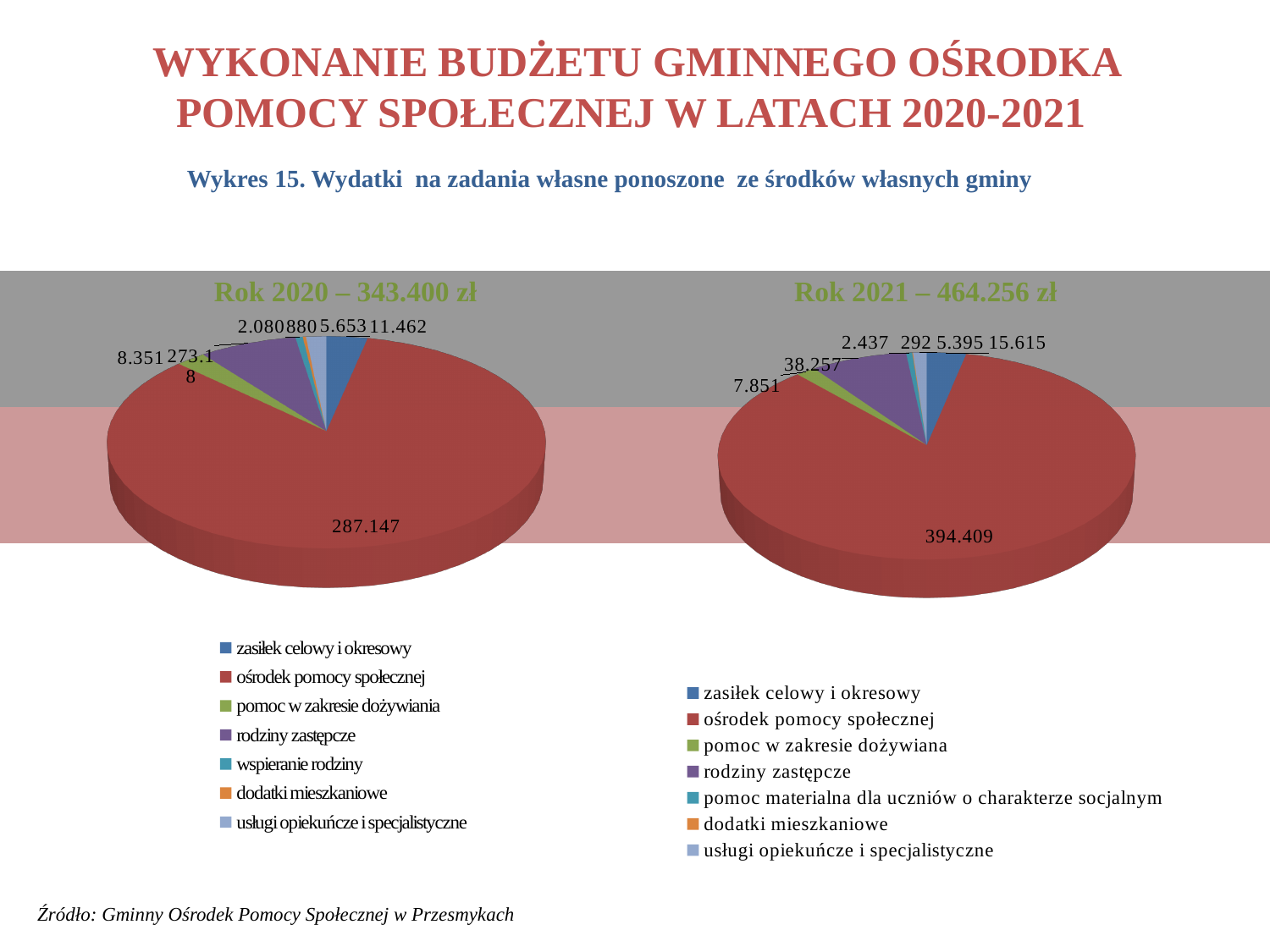
In the 'Rok 2021 – 464.256 zł' chart, what is the smallest labelled value? 292 In the 'Rok 2020 – 343.400 zł' chart, what is the value for 'ośrodek pomocy społecznej'? 287.147 In the 'Rok 2021 – 464.256 zł' chart, what is the value for 'ośrodek pomocy społecznej'? 394.409 What is the difference between the 'ośrodek pomocy społecznej' value in the 2021 chart (394.409) and in the 2020 chart (287.147)? 107.262 Which is larger: the 'ośrodek pomocy społecznej' value in the 2020 chart or in the 2021 chart? 2021 chart How many entries does the legend of the 'Rok 2021 – 464.256 zł' chart list? 7 In the 'Rok 2021 – 464.256 zł' chart, what is the value of the largest slice? 394.409 What is the title of the left pie chart? Rok 2020 – 343.400 zł In the 'Rok 2021 – 464.256 zł' chart, what is the value for 'rodziny zastępcze'? 38.257 In the 'Rok 2021 – 464.256 zł' chart, what is the value for 'zasiłek celowy i okresowy'? 15.615 What type of charts are shown on the slide? Pie charts In the 'Rok 2020 – 343.400 zł' chart, what is the value of the largest slice? 287.147